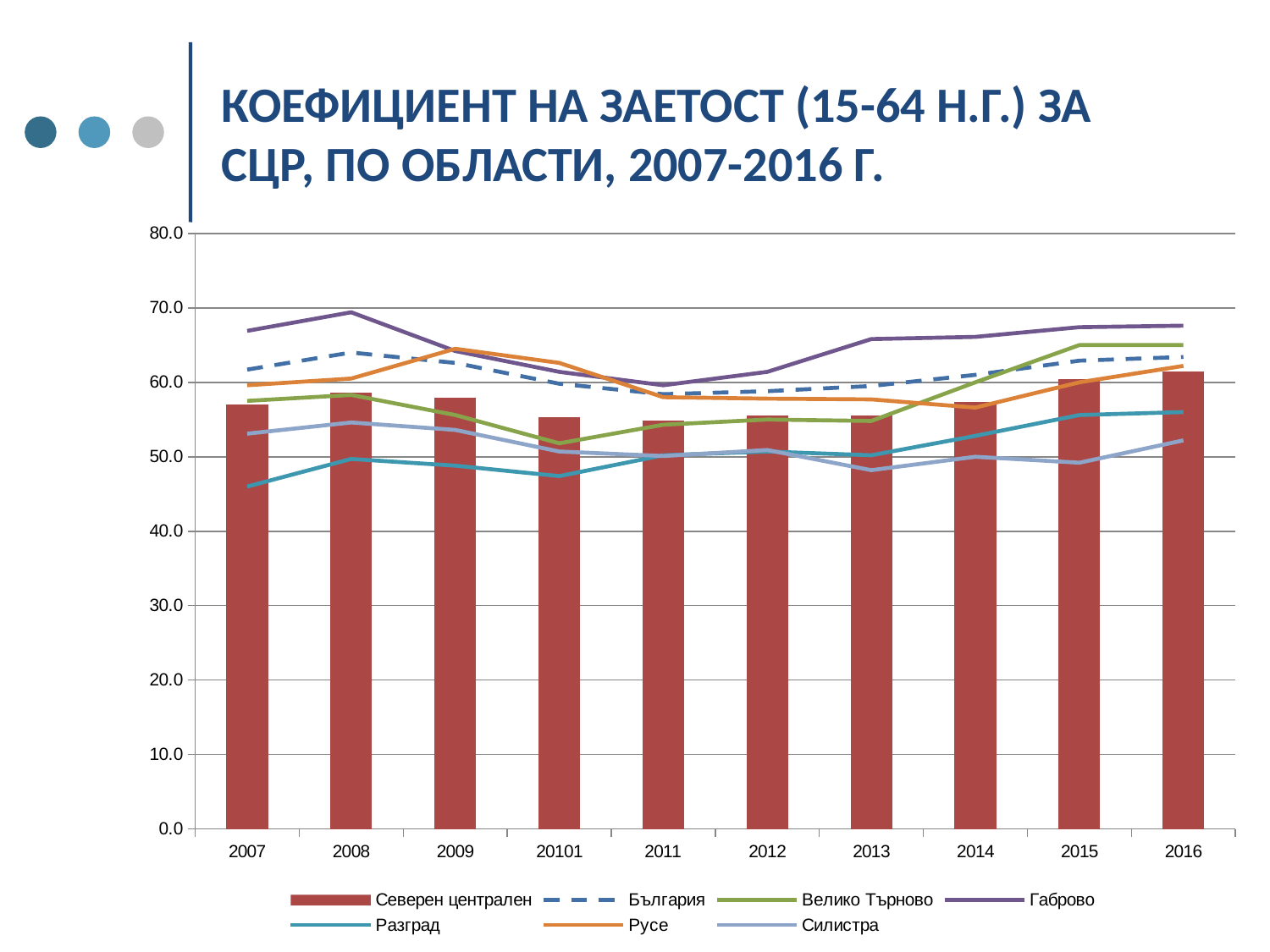
Is the value for Силистра in 2013 greater or less than 50.0? less Is the value of the Северен централен bar for 2016 greater or less than 60.0? greater What kind of chart is shown on the slide? A combined bar and line chart Which series is drawn with a dashed line? България Is the value for Разград in 2007 greater or less than 50.0? less Which series has the highest value in 2008? Габрово In 2013, which is larger: the value for Габрово or the value for Силистра? Габрово How many years (categories) are shown along the x axis? 10 How many series does the legend list? 7 Which series has the lowest value in 2007? Разград Do the Северен централен bars rise or fall from 2013 to 2016? rise